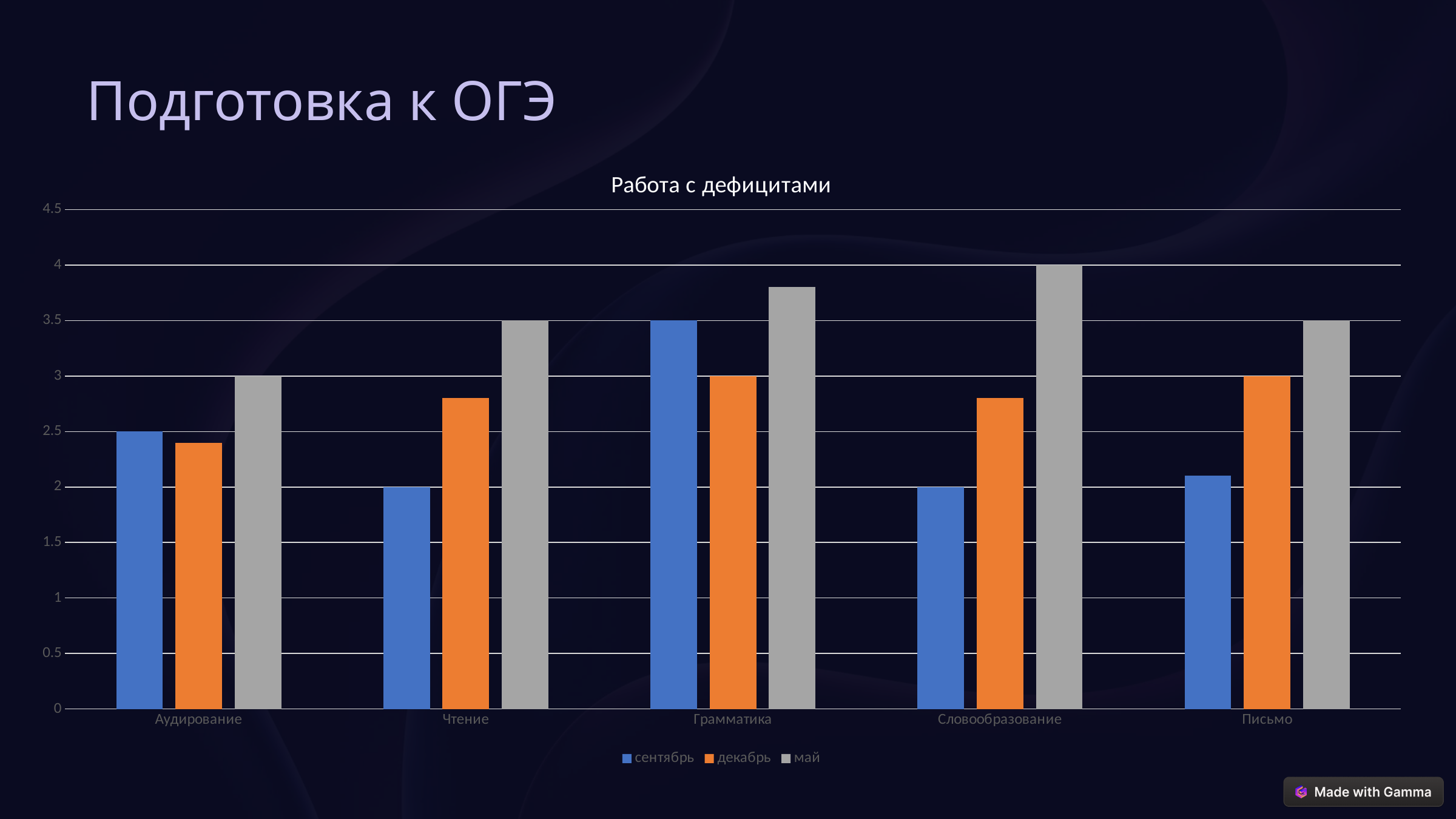
What is the difference between the май and сентябрь values in the Словообразование category? 2 What is the value for май in the Словообразование category? 4 Is the value for декабрь in the Аудирование category greater or less than 2.5? less What is the value for сентябрь in the Грамматика category? 3.5 What is the value for сентябрь in the Аудирование category? 2.5 What type of chart is shown on the slide? bar chart Which category has the lowest май value? Аудирование How many series does the legend list? 3 Which category has the highest май value? Словообразование What is the title of the chart? Работа с дефицитами Is the value for май in the Грамматика category greater or less than 3.5? greater How many categories are shown on the x axis? 5